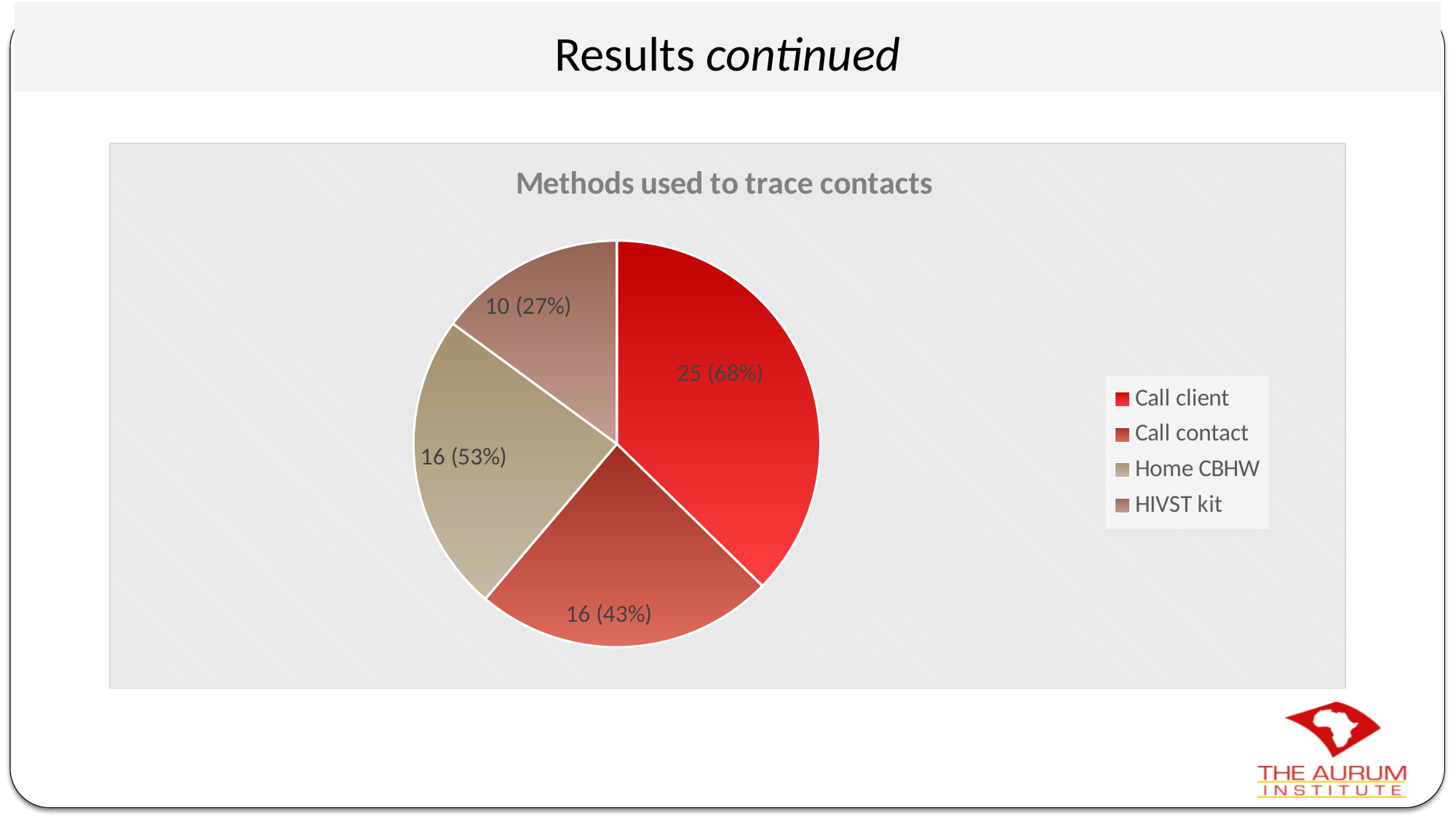
How many categories does the legend list? 4 What is the data label printed on the HIVST kit slice? 10 (27%) Which is larger, the count for Call client or the count for HIVST kit? Call client What is the title of the chart? Methods used to trace contacts Which method has the largest slice of the pie? Call client Which method has the smallest slice of the pie? HIVST kit What is the difference between the count for Call client and the count for HIVST kit? 15 What is the data label printed on the Call contact slice? 16 (43%) What is the data label printed on the Home CBHW slice? 16 (53%) Which legend entry is shown in bright red? Call client What type of chart is shown on the slide? Pie chart What is the data label printed on the Call client slice? 25 (68%)